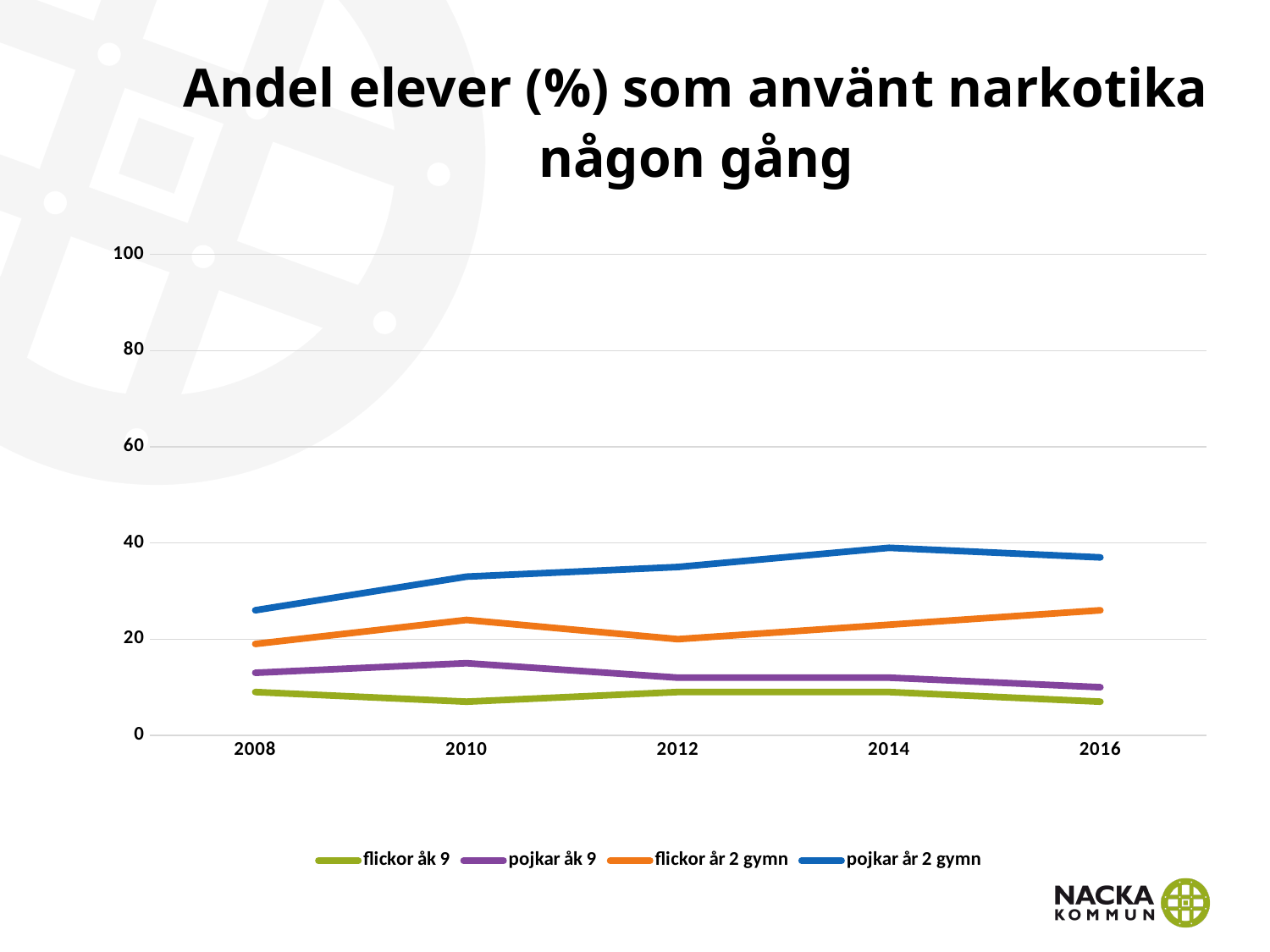
Is the value for pojkar åk 9 in 2010 greater or less than 20? less In 2012, which is larger: the value for flickor år 2 gymn or the value for pojkar åk 9? flickor år 2 gymn How many series does the legend list? 4 Is the value for pojkar år 2 gymn in 2008 greater or less than 20? greater How many years are shown on the x axis? 5 What kind of chart is shown on the slide? line chart Is the value for flickor år 2 gymn in 2016 greater or less than 20? greater Does the value for pojkar år 2 gymn rise or fall from 2008 to 2014? rise Which series has the lowest value in 2016? flickor åk 9 Which series has the highest value in 2014? pojkar år 2 gymn What colour is the line for pojkar år 2 gymn? blue